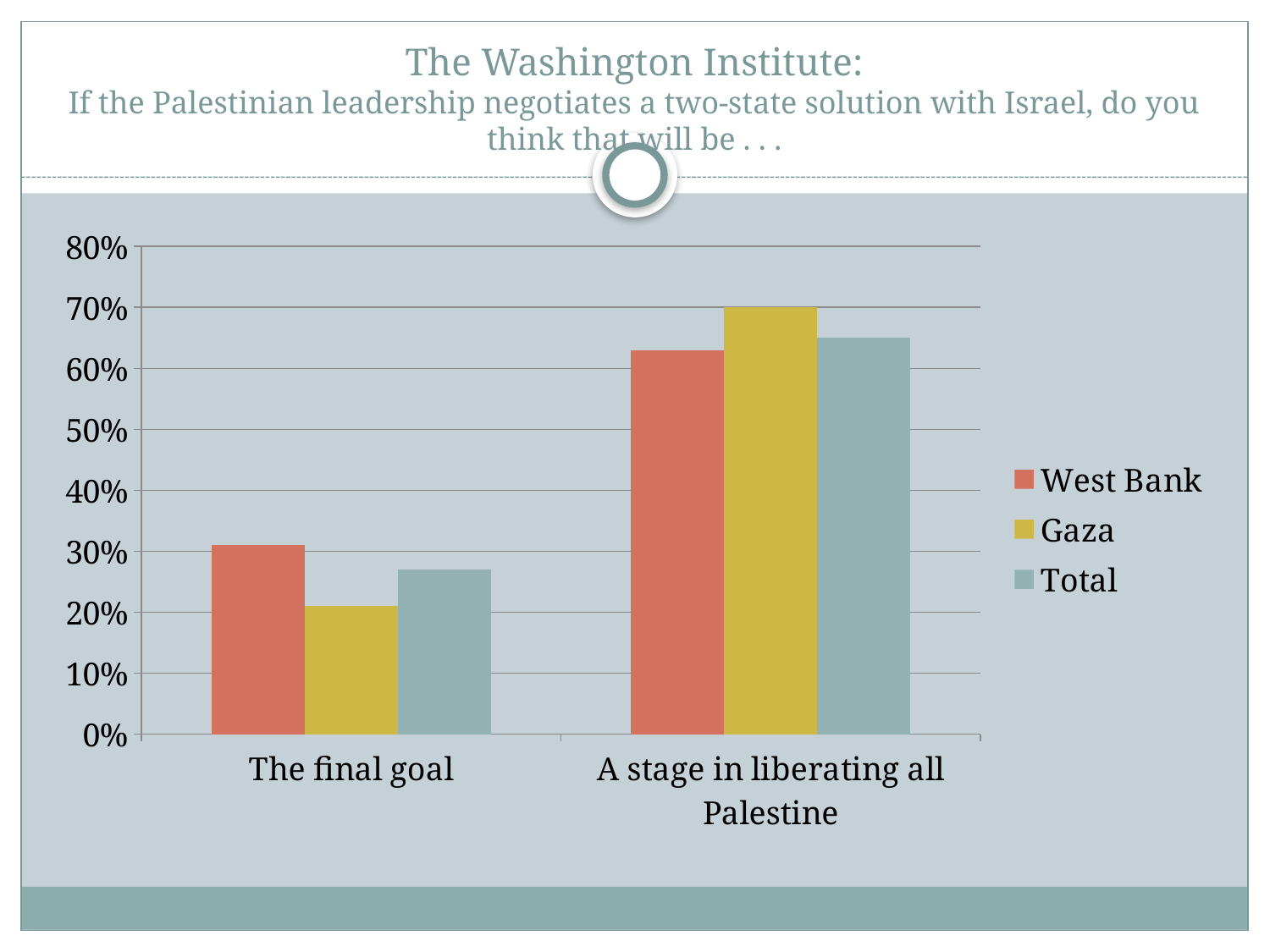
Which series has the highest value in the category "A stage in liberating all Palestine"? Gaza How many series does the legend list? 3 How many categories are shown on the x axis? 2 Is the value for Total in "The final goal" greater or less than 30%? less Is the value for West Bank in "The final goal" greater or less than 20%? greater What is the value for Gaza in the category "A stage in liberating all Palestine"? 70% What kind of chart is shown on the slide? bar chart Which colour represents the Total series in the legend? grey-blue Which series has the highest value in the category "The final goal"? West Bank Is the value for West Bank in "A stage in liberating all Palestine" greater or less than 60%? greater Which series has the lowest value in the category "The final goal"? Gaza Which is larger for Gaza: "The final goal" or "A stage in liberating all Palestine"? A stage in liberating all Palestine